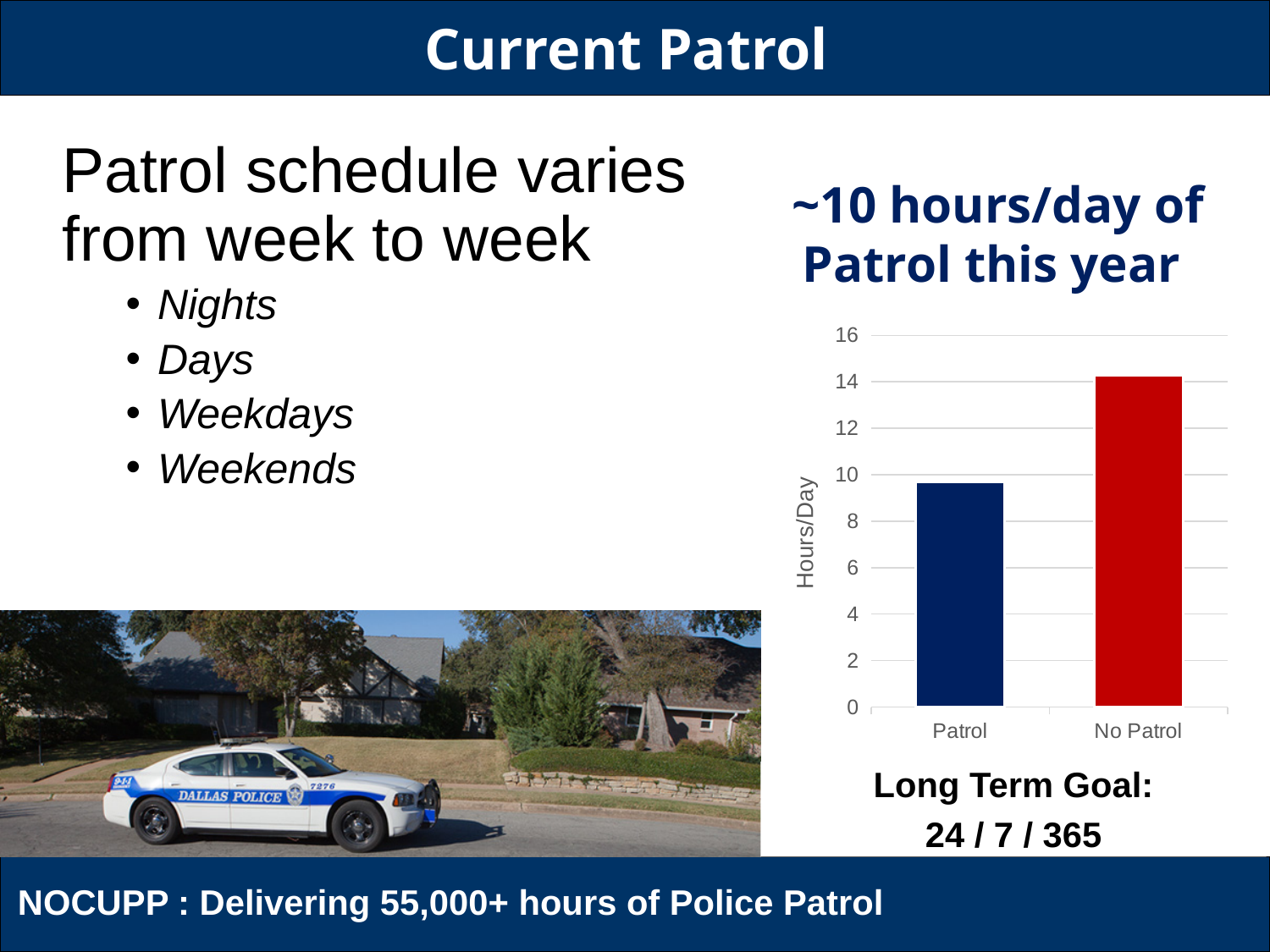
What colour is the bar for No Patrol? red Is the value for Patrol greater or less than 8? greater What kind of chart is shown on the slide? bar chart Is the value for No Patrol greater or less than 12? greater Which category has the lowest value in the chart? Patrol Which is larger, the value for Patrol or the value for No Patrol? No Patrol Which category has the highest value in the chart? No Patrol How many categories are shown on the x axis of the chart? 2 What is the label on the vertical axis of the chart? Hours/Day Is the value for No Patrol greater or less than 16? less